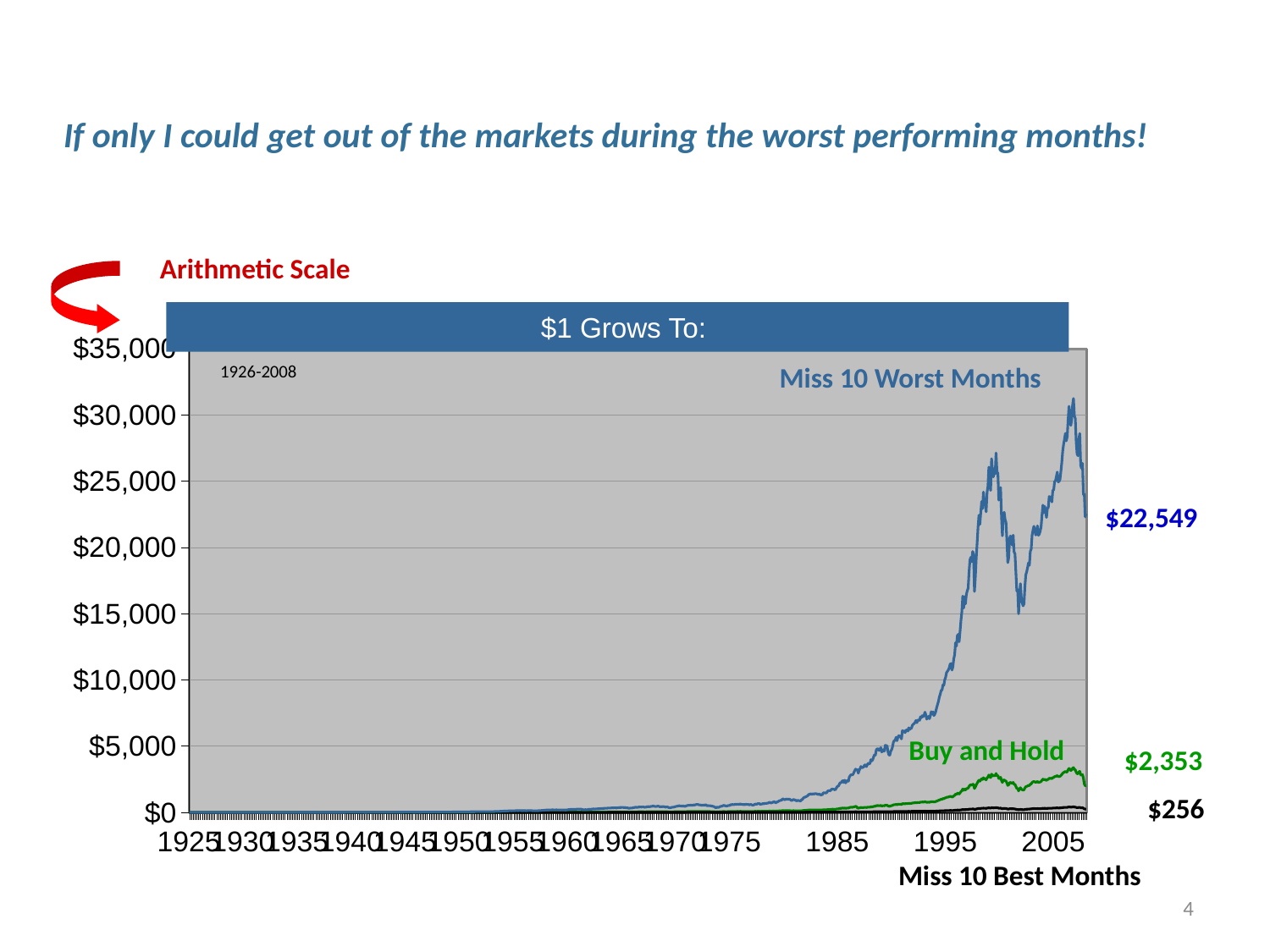
What kind of chart is shown on the slide? line chart What is the difference between the final values of Miss 10 Worst Months and Buy and Hold? $20,196 Which series ends with the lowest value? Miss 10 Best Months Which series ends with the highest value? Miss 10 Worst Months How many series are plotted on the chart? 3 Which ends higher, Buy and Hold or Miss 10 Best Months? Buy and Hold Is the peak value of the Miss 10 Worst Months line greater or less than $30,000? greater What is the final value shown for the Miss 10 Worst Months series? $22,549 What is the difference between the final values of Buy and Hold and Miss 10 Best Months? $2,097 What is the final value shown for the Miss 10 Best Months series? $256 What is the final value shown for the Buy and Hold series? $2,353 What is the title of the chart? $1 Grows To: